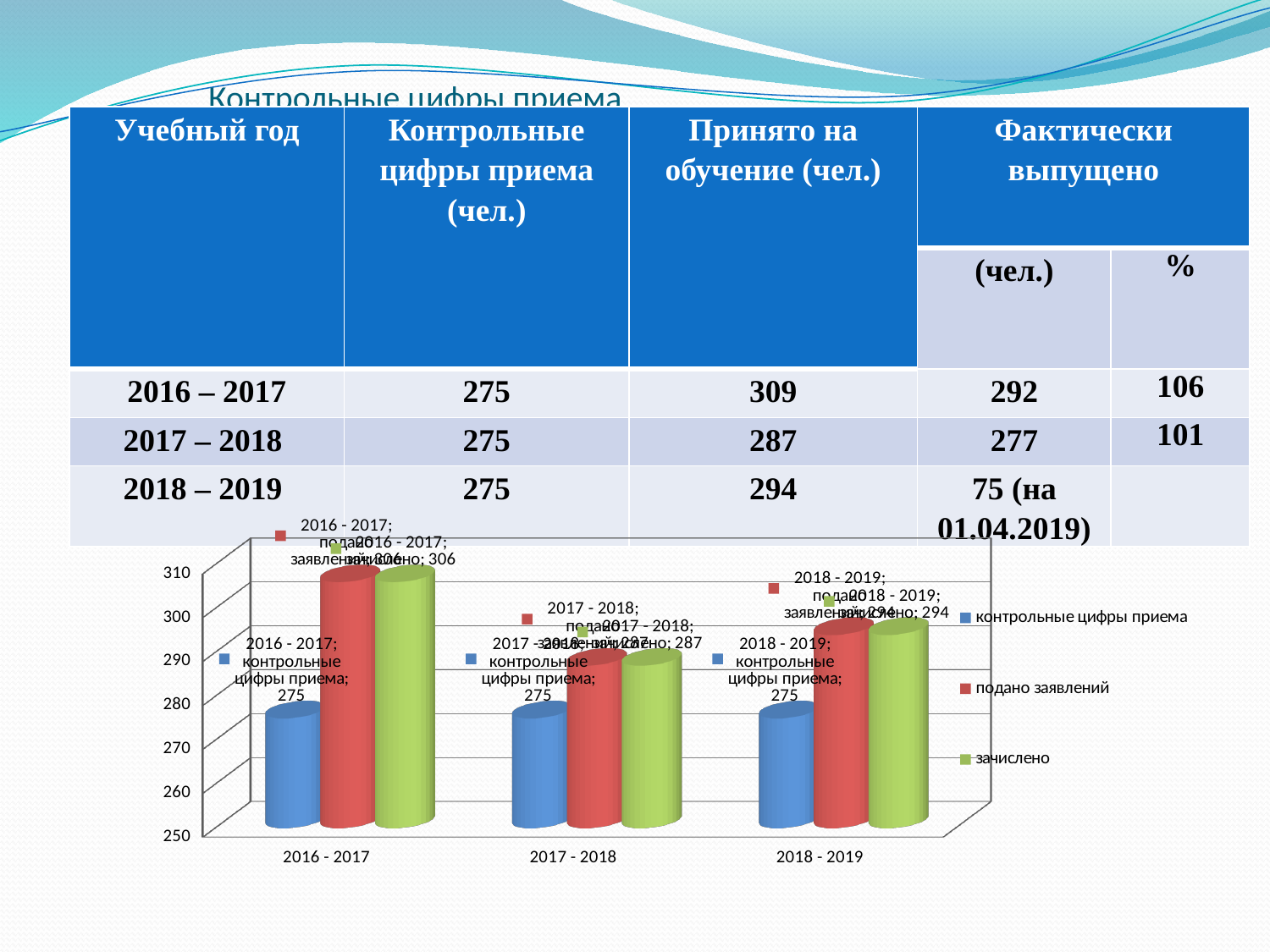
Which series is shown in red on the chart? подано заявлений How many academic-year categories are shown on the chart's x axis? 3 Which academic year has the lowest 'зачислено' value on the chart? 2017 - 2018 What is the value of 'зачислено' for 2017 - 2018 on the chart? 287 On the chart, is the 'зачислено' value for 2018 - 2019 larger than the 'контрольные цифры приема' value for 2018 - 2019? Yes Which academic year has the highest 'зачислено' value on the chart? 2016 - 2017 What is the value of 'контрольные цифры приема' for 2016 - 2017 on the chart? 275 What kind of chart is shown at the bottom of the slide? bar chart What is the value of 'зачислено' for 2018 - 2019 on the chart? 294 What is the value of 'зачислено' for 2016 - 2017 on the chart? 306 What is the difference between the 'зачислено' values for 2016 - 2017 and 2017 - 2018 on the chart? 19 How many series does the chart legend list? 3